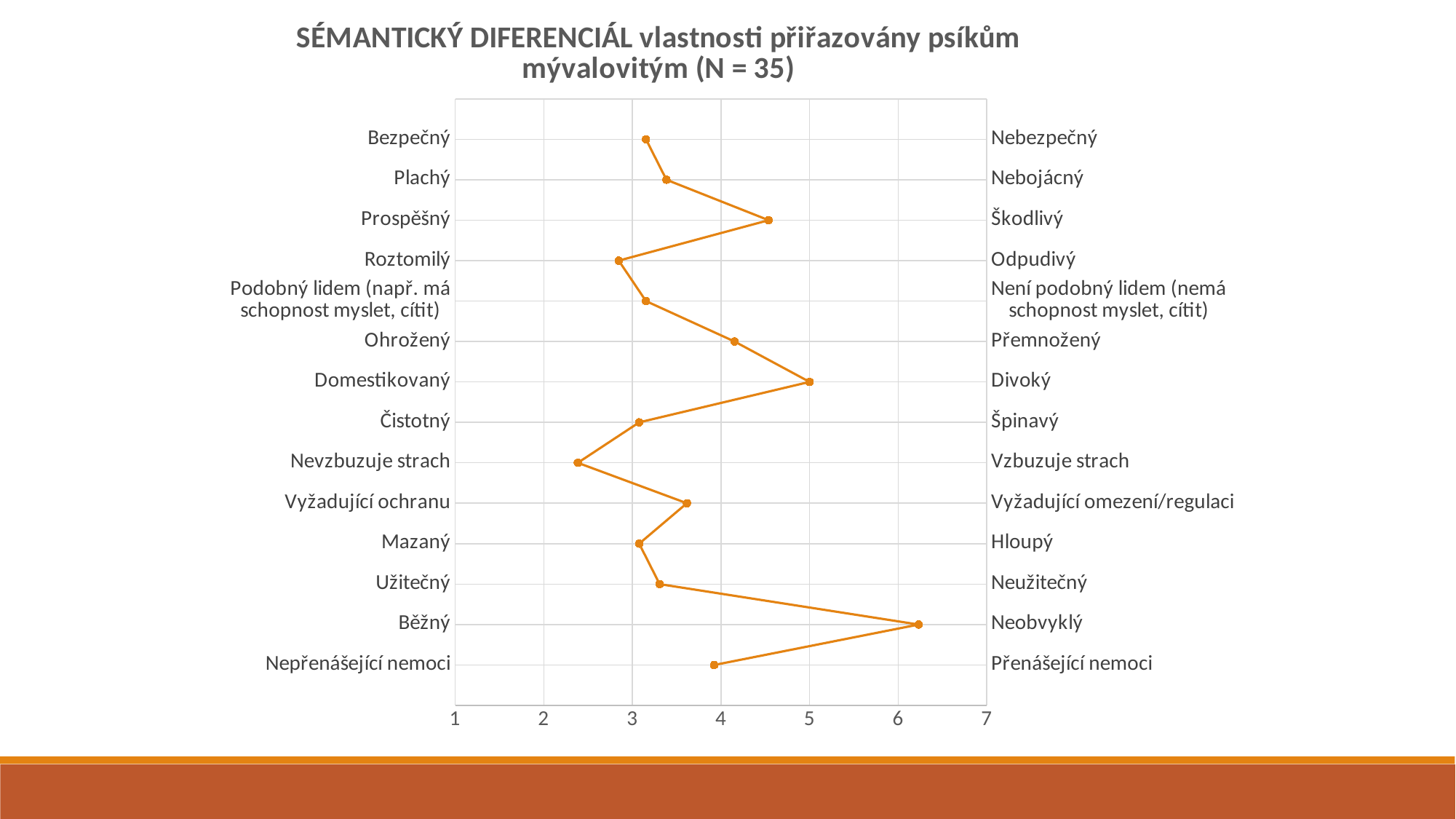
Is the value for Roztomilý – Odpudivý greater or less than 3? less How many attribute pairs (rows) are plotted on the chart? 14 What is the range of the horizontal axis on the chart? 1 to 7 Is the value for Běžný – Neobvyklý greater or less than 6? greater What kind of chart is shown on the slide? line chart Which has the larger value: Prospěšný – Škodlivý or Plachý – Nebojácný? Prospěšný – Škodlivý Which attribute pair has the highest plotted value? Běžný – Neobvyklý Which has the larger value: Domestikovaný – Divoký or Čistotný – Špinavý? Domestikovaný – Divoký Is the value for Prospěšný – Škodlivý greater or less than 4? greater Which attribute pair has the lowest plotted value? Nevzbuzuje strach – Vzbuzuje strach What is the sample size stated in the chart title? N = 35